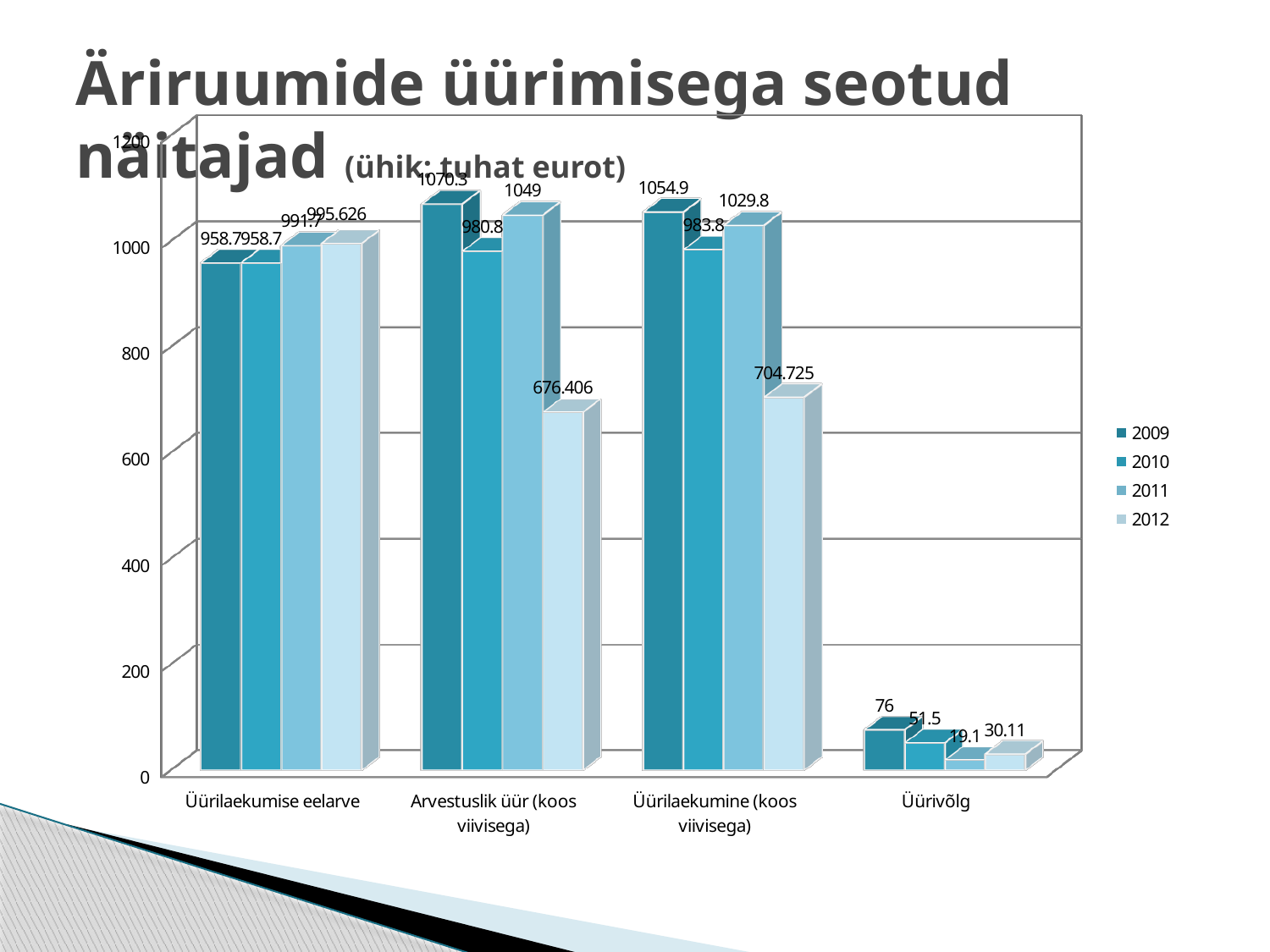
What kind of chart is shown on the slide? Bar chart What is the 2011 value for Arvestuslik üür (koos viivisega)? 1049 How many series does the legend list? 4 What is the 2009 value for Üürilaekumine (koos viivisega)? 1054.9 In which year was Üürivõlg the lowest? 2011 What is the 2012 value for Üürivõlg? 30.11 In which year was Üürivõlg the highest? 2009 For 2012, which is larger: Arvestuslik üür (koos viivisega) or Üürilaekumine (koos viivisega)? Üürilaekumine (koos viivisega) How many categories are shown on the x axis? 4 What unit does the chart title say the values are in? tuhat eurot What is the difference between the 2009 and 2010 values for Üürivõlg? 24.5 What is the 2012 value for Üürilaekumise eelarve? 995.626